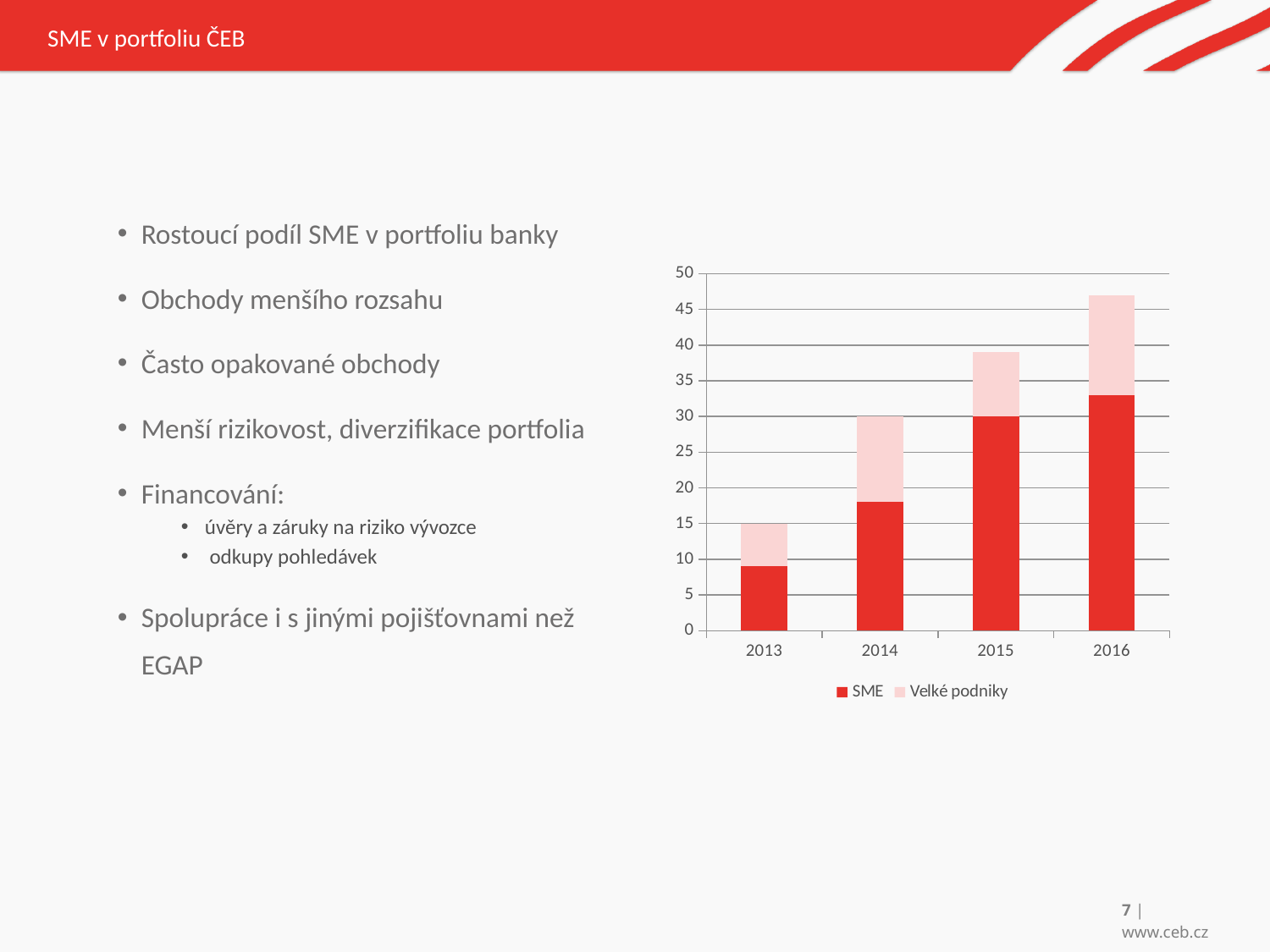
Is the total height of the 2016 bar greater or less than 45? greater Do the SME values rise or fall from 2013 to 2016? rise Which two series are listed in the chart legend? SME and Velké podniky Which year has the shortest stacked bar in the chart? 2013 Is the SME value for 2013 greater or less than 10? less Which year has a larger SME value, 2014 or 2016? 2016 Is the SME value for 2014 greater or less than 15? greater Which year has the tallest stacked bar in the chart? 2016 What kind of chart is shown on the slide? bar chart How many series does the chart legend list? 2 How many years are shown on the x axis of the chart? 4